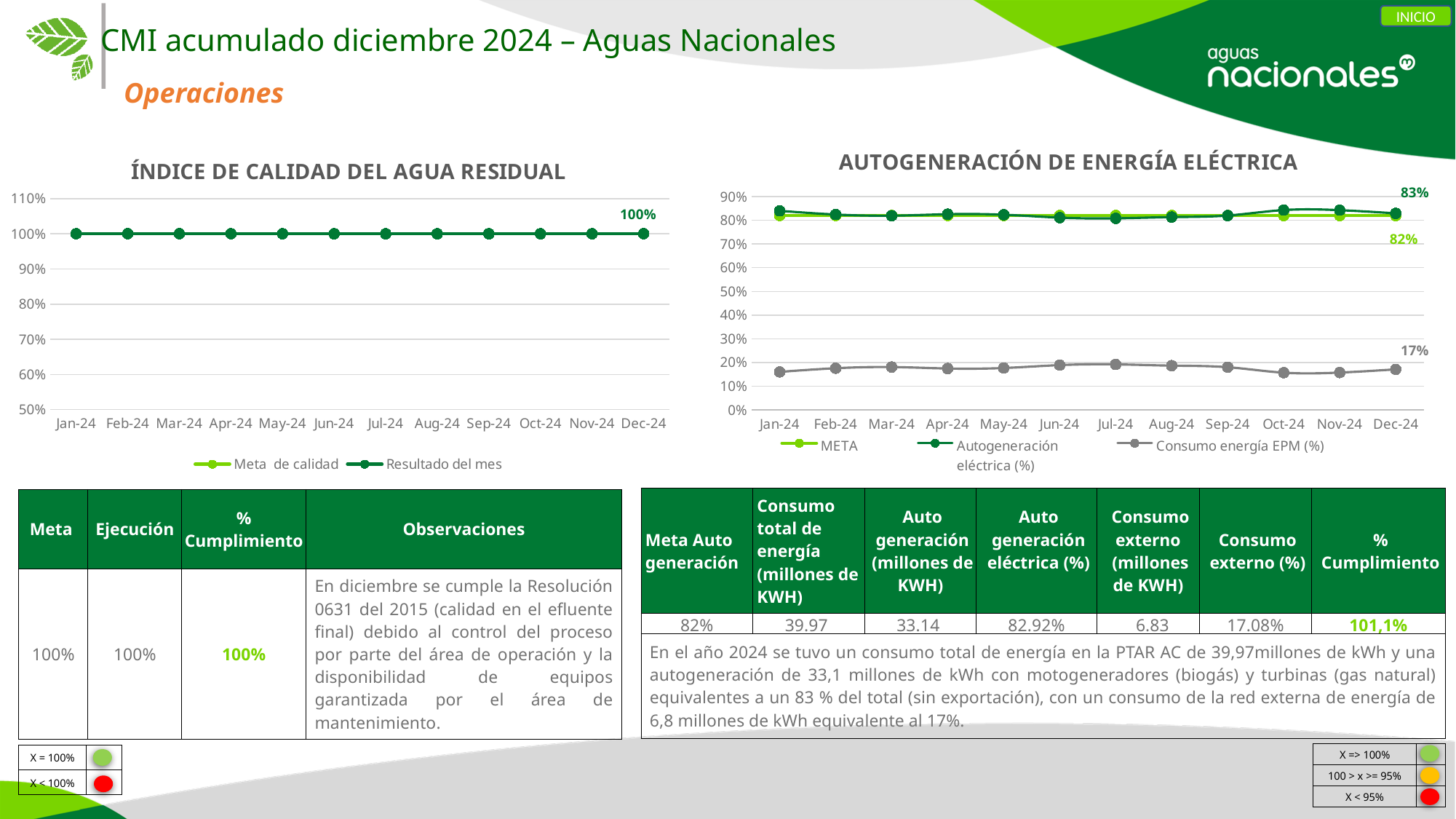
In the 'AUTOGENERACIÓN DE ENERGÍA ELÉCTRICA' chart, which series is higher in Dec-24: 'Autogeneración eléctrica (%)' or 'Consumo energía EPM (%)'? Autogeneración eléctrica (%) How many series does the legend of the 'AUTOGENERACIÓN DE ENERGÍA ELÉCTRICA' chart list? 3 In the 'AUTOGENERACIÓN DE ENERGÍA ELÉCTRICA' chart, is the value for 'Consumo energía EPM (%)' in Jan-24 greater or less than 20%? less What kind of chart is the 'ÍNDICE DE CALIDAD DEL AGUA RESIDUAL' chart? Line chart How many months are plotted on the x axis of the 'ÍNDICE DE CALIDAD DEL AGUA RESIDUAL' chart? 12 In the 'AUTOGENERACIÓN DE ENERGÍA ELÉCTRICA' chart, what is the difference between the Dec-24 labelled values of 'Autogeneración eléctrica (%)' and 'Consumo energía EPM (%)'? 66 percentage points In the 'AUTOGENERACIÓN DE ENERGÍA ELÉCTRICA' chart, what is the labelled value of 'Autogeneración eléctrica (%)' for Dec-24? 83% In the 'ÍNDICE DE CALIDAD DEL AGUA RESIDUAL' chart, do the values rise, fall or stay flat from Jan-24 to Dec-24? Stay flat How many series does the legend of the 'ÍNDICE DE CALIDAD DEL AGUA RESIDUAL' chart list? 2 In the 'AUTOGENERACIÓN DE ENERGÍA ELÉCTRICA' chart, what is the labelled value of 'META' for Dec-24? 82% In the 'ÍNDICE DE CALIDAD DEL AGUA RESIDUAL' chart, what value is labelled for Dec-24? 100% In the 'AUTOGENERACIÓN DE ENERGÍA ELÉCTRICA' chart, what is the labelled value of 'Consumo energía EPM (%)' for Dec-24? 17%